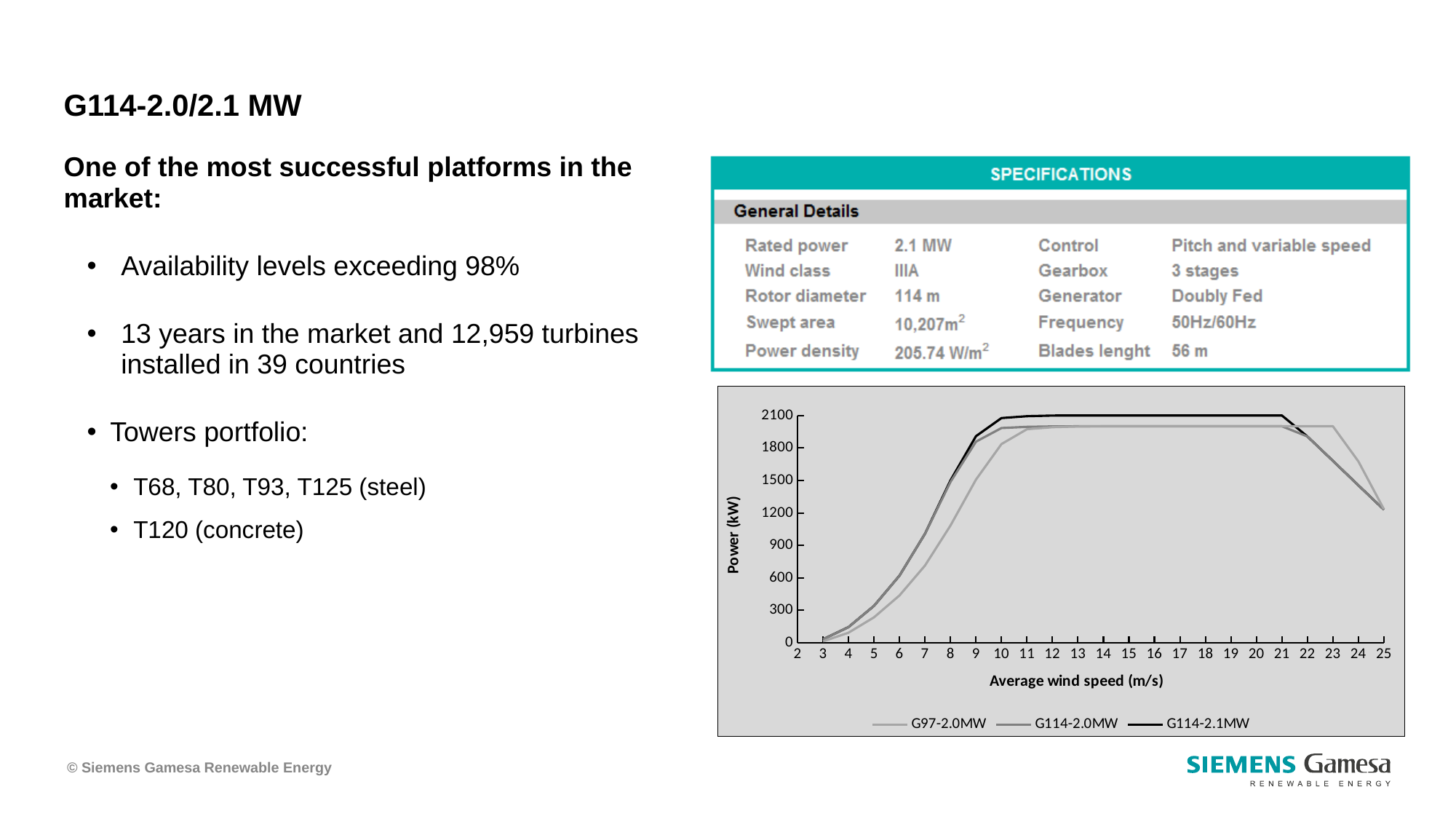
Which series reaches the highest power on the chart? G114-2.1MW What is the title of the chart's y axis? Power (kW) Is the power for G114-2.1MW at 25 m/s greater or less than 1500? less Is the power for G114-2.0MW at 6 m/s greater or less than 900? less Is the power for G114-2.1MW at 15 m/s greater or less than 1800? greater How many series does the chart legend list? 3 What kind of chart is shown on the slide? line chart At 9 m/s, which series has the higher power, G114-2.1MW or G97-2.0MW? G114-2.1MW At 23 m/s, which series has the higher power, G97-2.0MW or G114-2.1MW? G97-2.0MW Between 3 m/s and 10 m/s, does the power for G114-2.1MW rise or fall? rise What is the title of the chart's x axis? Average wind speed (m/s)